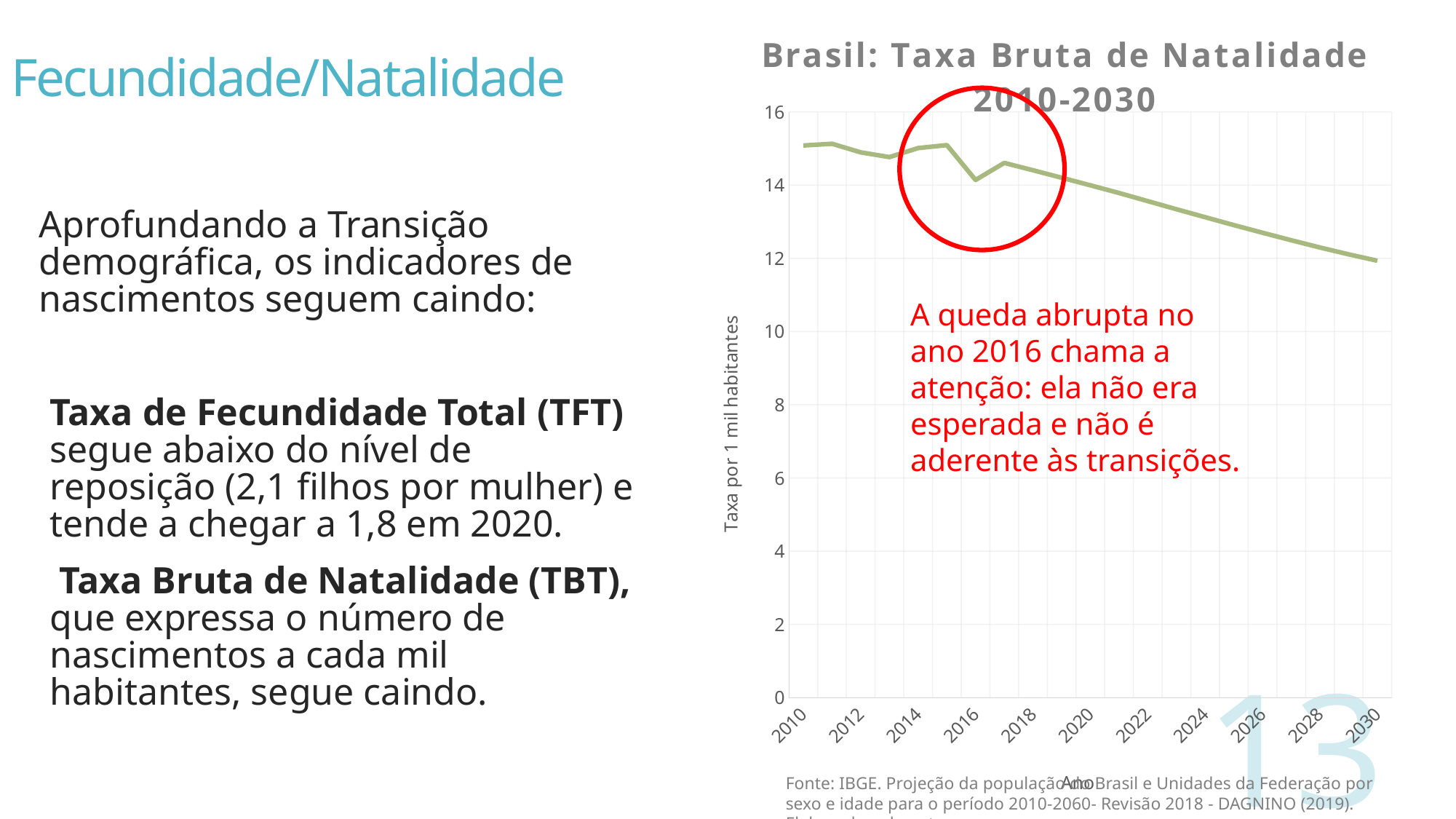
How many year labels are shown on the x axis of the chart? 11 Is the value for 2030 greater or less than 14? less Is the value for 2024 greater or less than 14? less What is the label of the y axis of the chart? Taxa por 1 mil habitantes What is the title of the chart? Brasil: Taxa Bruta de Natalidade 2010-2030 Does the birth rate line rise or fall overall from 2010 to 2030? fall Is the value for 2016 greater or less than 12? greater What kind of chart is shown on the slide? line chart Which year has the larger value, 2016 or 2026? 2016 Which year has the larger value, 2010 or 2030? 2010 Which year has the lowest value on the chart? 2030